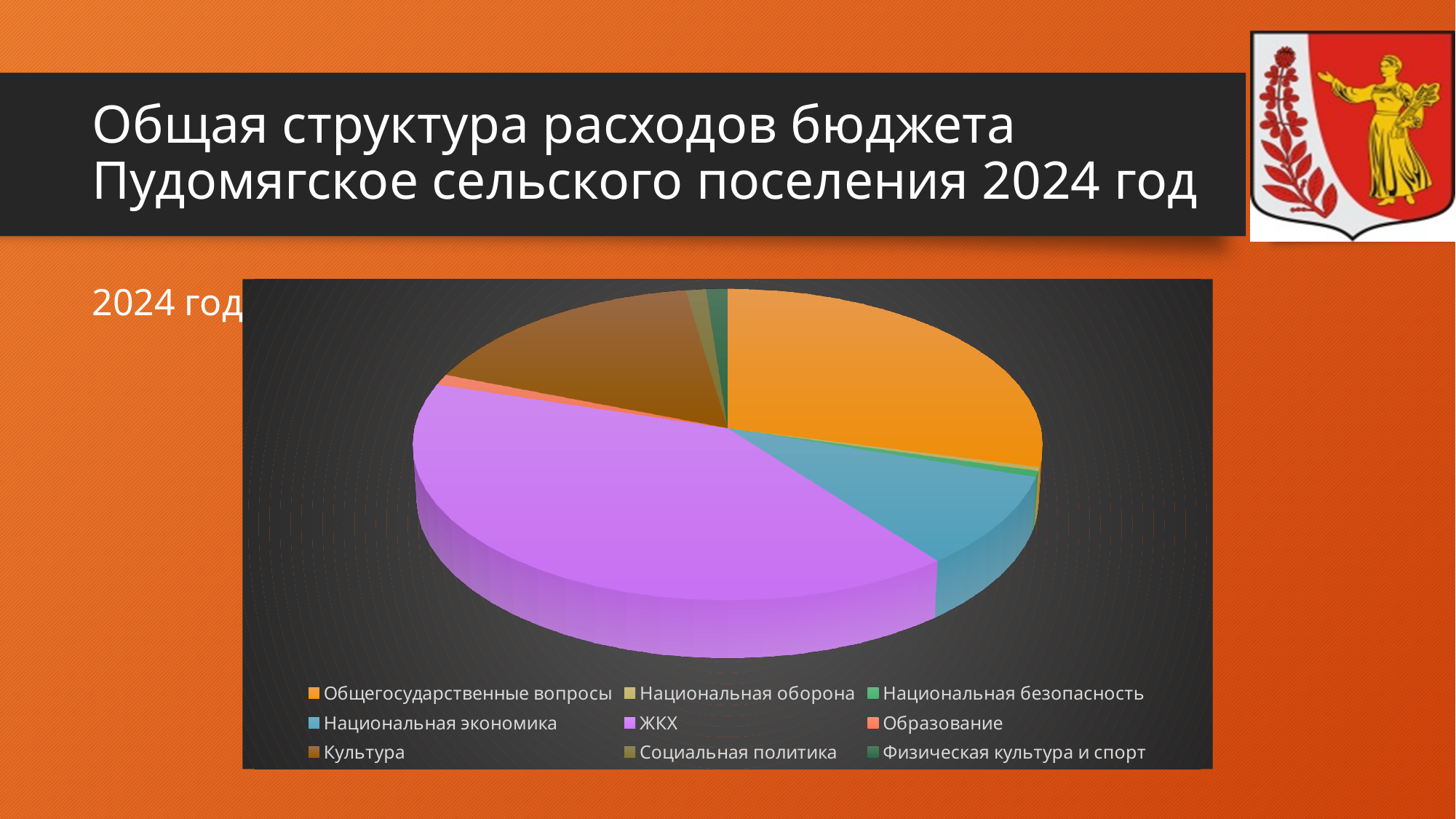
Which slice is larger: Культура or Образование? Культура Which slice is larger: Национальная экономика or Физическая культура и спорт? Национальная экономика Which slice is larger: Общегосударственные вопросы or Национальная экономика? Общегосударственные вопросы What kind of chart is shown on the slide? pie chart How many categories does the legend of the pie chart list? 9 What colour is the ЖКХ slice in the pie chart? purple Which category has the largest slice of the pie chart? ЖКХ What is the title shown next to the pie chart? 2024 год